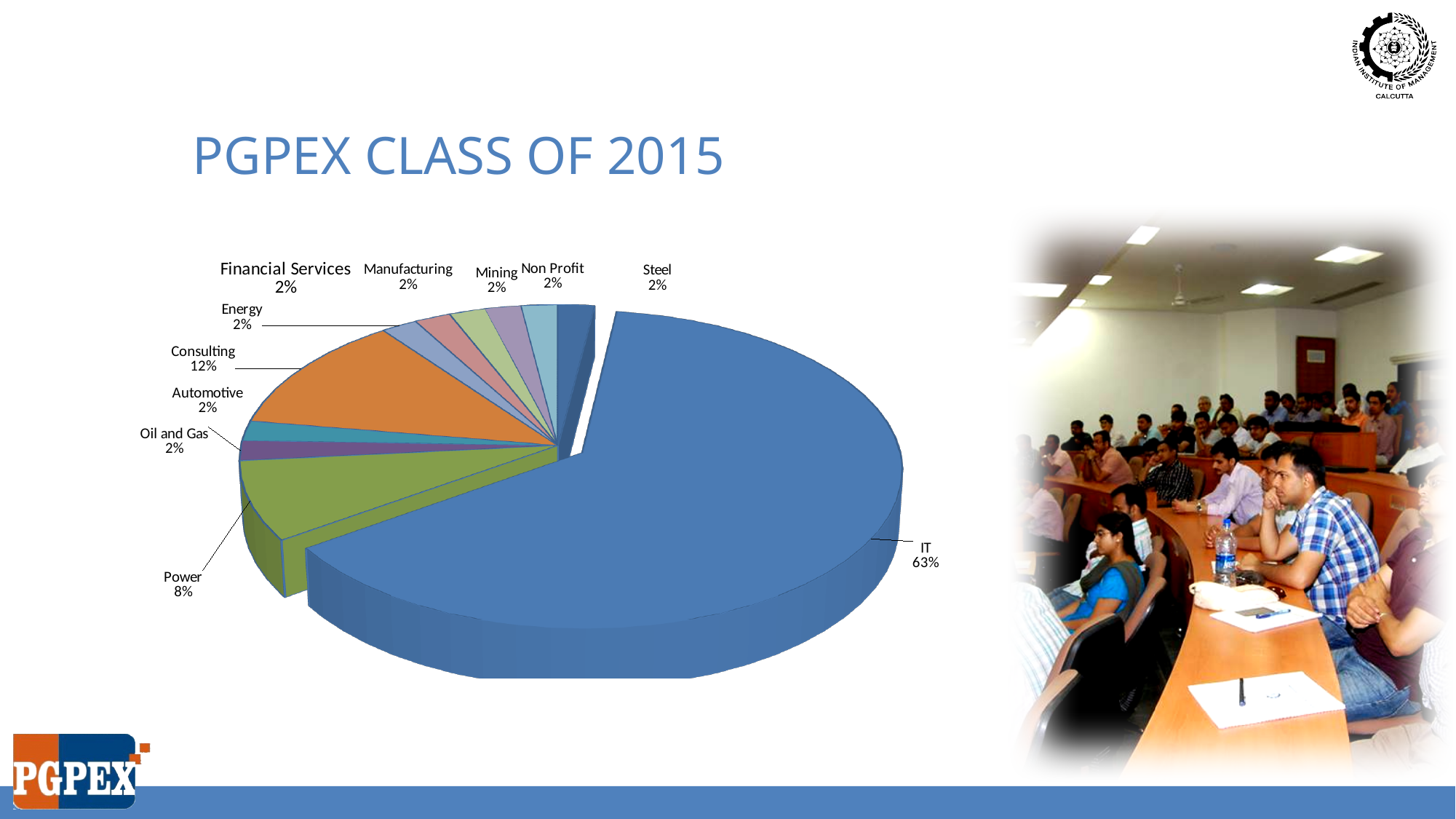
What is the difference in percentage points between IT and Consulting? 51 How many categories are shown in the pie chart? 11 What kind of chart is shown on the slide? Pie chart What is the title of the slide containing the chart? PGPEX CLASS OF 2015 What is the value shown for Power? 8% What is the value shown for Financial Services? 2% What share of the pie does IT account for? 63% Which is larger, Consulting or Power? Consulting What is the value shown for Consulting? 12% What is the difference in percentage points between Consulting and Power? 4 Which category has the largest slice of the pie? IT What is the value shown for Oil and Gas? 2%